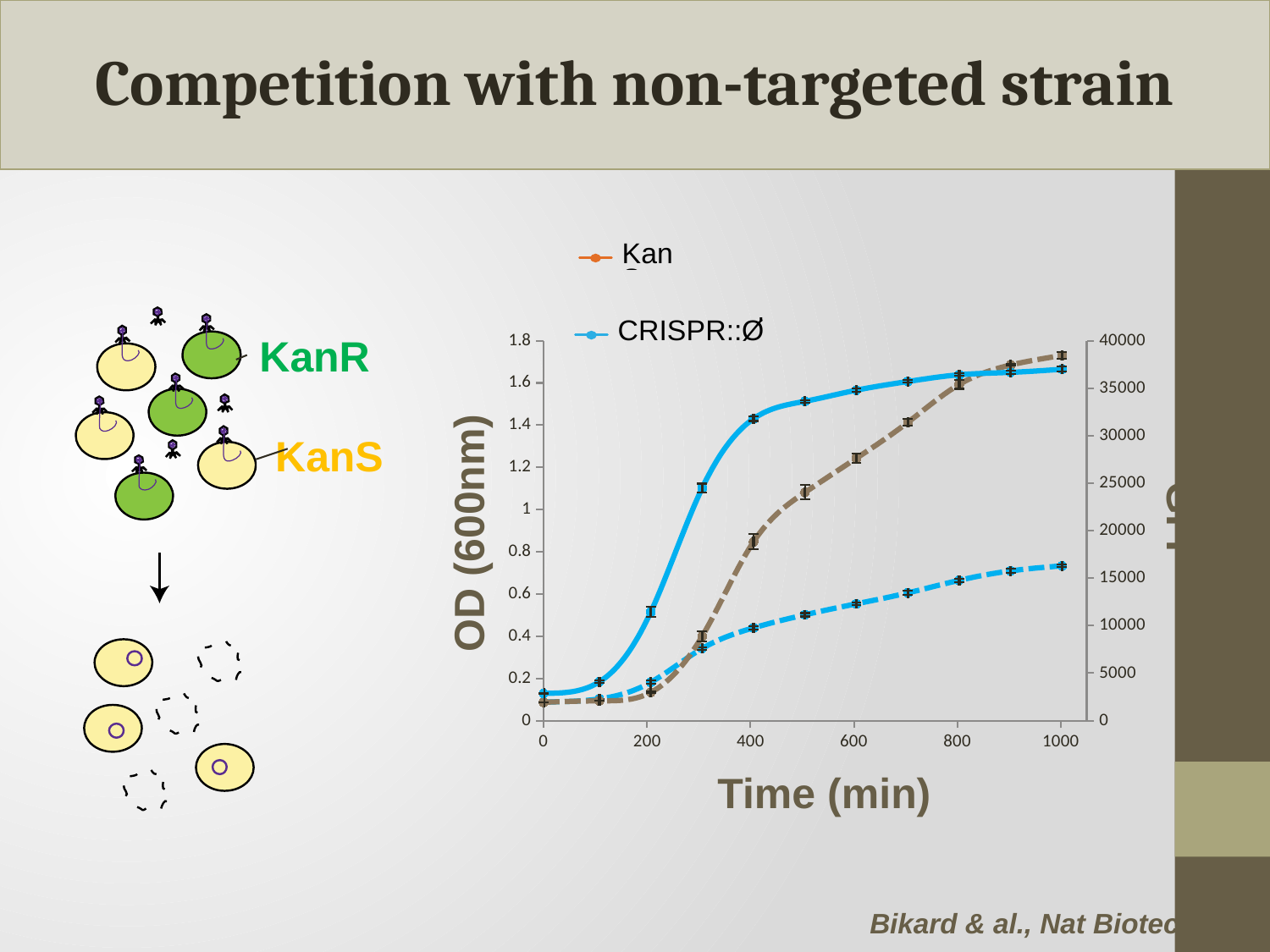
How many series does the legend of the chart list? 2 Is the value of the solid blue line at 200 min greater or less than 0.4 on the left axis? greater Is the value of the dashed blue line at 1000 min greater or less than 0.8 on the left axis? less What is the title of the x axis of the chart? Time (min) What is the highest tick value shown on the left y axis? 1.8 Does the solid blue CRISPR::Ø line rise or fall as time increases from 0 to 1000 min? rise What is the title of the left y axis of the chart? OD (600nm) At 300 min, which is higher: the solid blue line or the dashed brown Kan line? the solid blue line How many tick labels are shown on the x axis? 6 What is the highest tick value shown on the right y axis? 40000 What kind of chart is shown on the slide? line chart Is the value of the solid blue CRISPR::Ø line at 1000 min greater or less than 1.6 on the left axis? greater